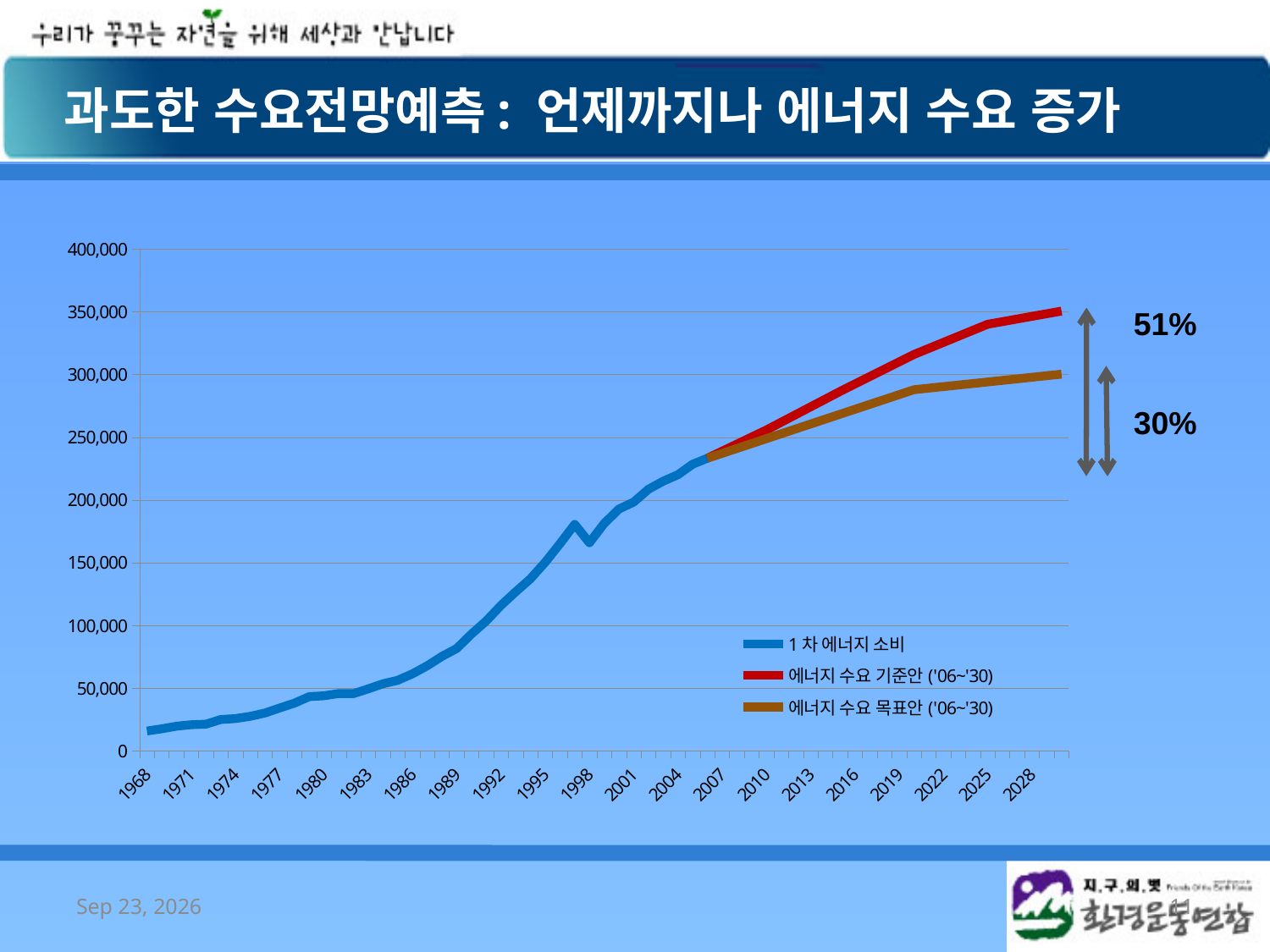
At the end of the projection period (around 2028), which series is higher: 에너지 수요 기준안 ('06~'30) or 에너지 수요 목표안 ('06~'30)? 에너지 수요 기준안 ('06~'30) Is the value of 1 차 에너지 소비 in 1998 greater or less than 150,000? greater Is the value of 1 차 에너지 소비 in 1989 greater or less than 100,000? less Is the value of 에너지 수요 목표안 ('06~'30) in 2028 greater or less than 350,000? less How many series does the chart legend list? 3 Which series is drawn in red according to the legend? 에너지 수요 기준안 ('06~'30) What is the title of the slide containing the chart? 과도한 수요전망예측 : 언제까지나 에너지 수요 증가 Does the 1 차 에너지 소비 series generally rise or fall from 1968 to 2007? rise What type of chart is shown on the slide? line chart